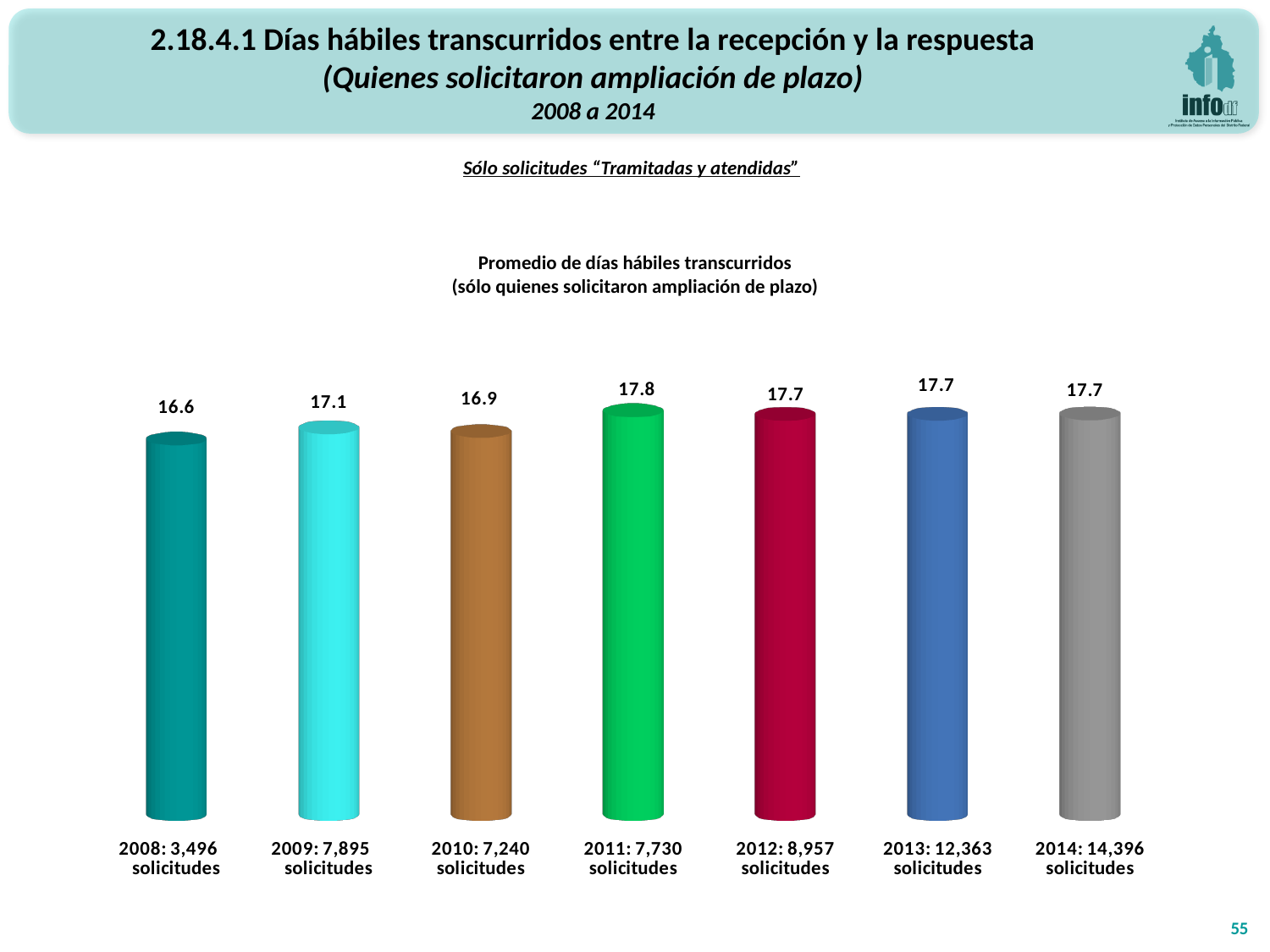
How many solicitudes are indicated in the category label for 2014? 14,396 What is the value shown for 2010? 16.9 Which is larger, the value for 2009 or the value for 2010? 2009 Which year has the lowest average number of business days? 2008 What is the average number of business days shown for 2008? 16.6 How many bars are shown in the chart? 7 Which year has the highest average number of business days? 2011 What is the difference between the values for 2009 and 2010? 0.2 What is the difference between the values for 2011 and 2008? 1.2 What kind of chart is shown on the slide? Bar chart What is the title of the chart? Promedio de días hábiles transcurridos (sólo quienes solicitaron ampliación de plazo) What is the value of the bar for 2011? 17.8